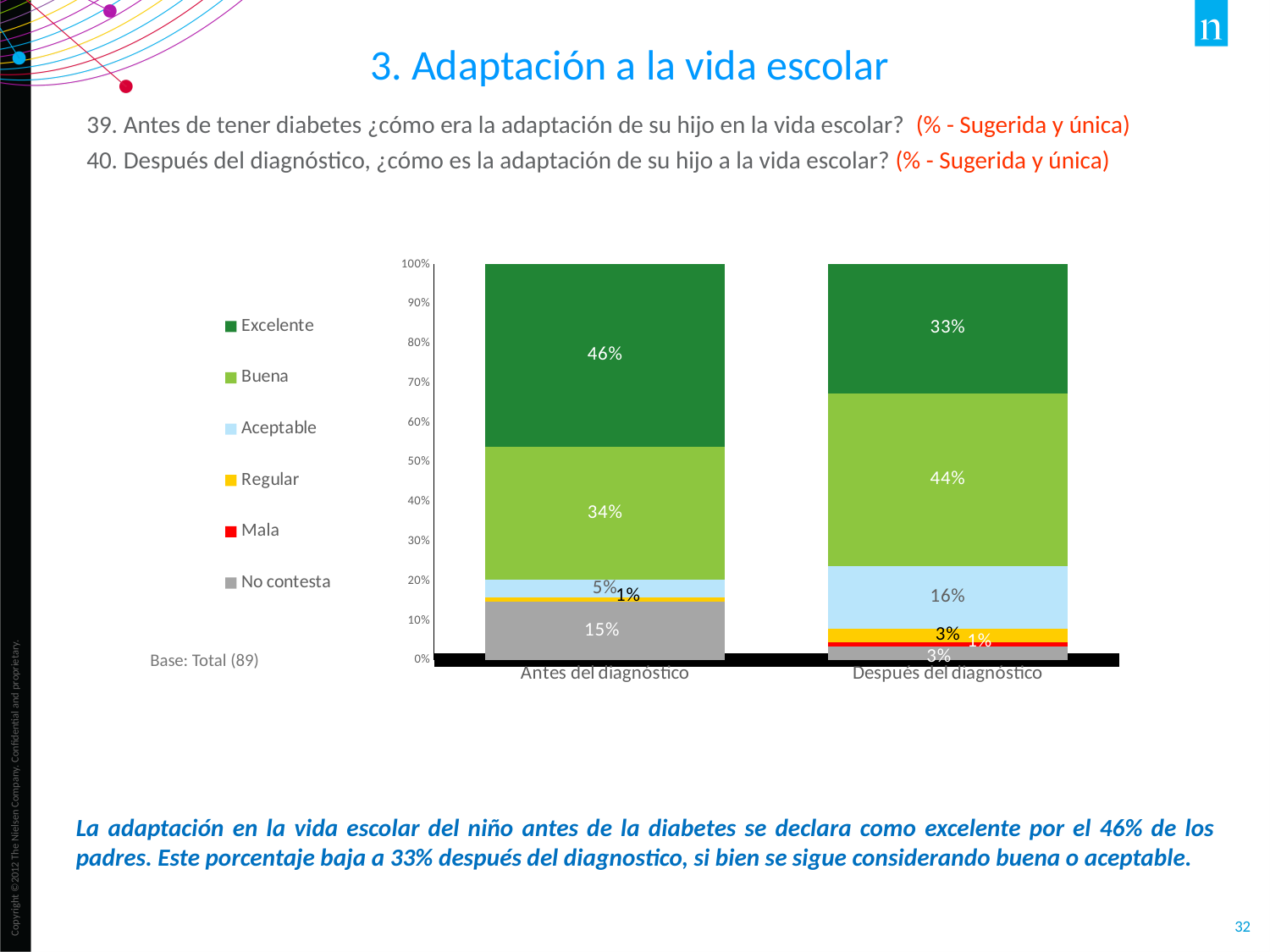
How many series does the legend list? 6 What type of chart is shown on the slide? stacked bar chart How many categories are shown on the x axis? 2 What is the value for Excelente in the Después del diagnóstico bar? 33% What is the value for No contesta in the Antes del diagnóstico bar? 15% Which category has the larger Buena value, Antes del diagnóstico or Después del diagnóstico? Después del diagnóstico Which legend entry is shown in red? Mala What is the value for Aceptable in the Después del diagnóstico bar? 16% What is the value for Buena in the Después del diagnóstico bar? 44% What is the value for Excelente in the Antes del diagnóstico bar? 46% What is the difference between the Excelente values for Antes del diagnóstico and Después del diagnóstico? 13% Which series is the largest segment in the Antes del diagnóstico bar? Excelente